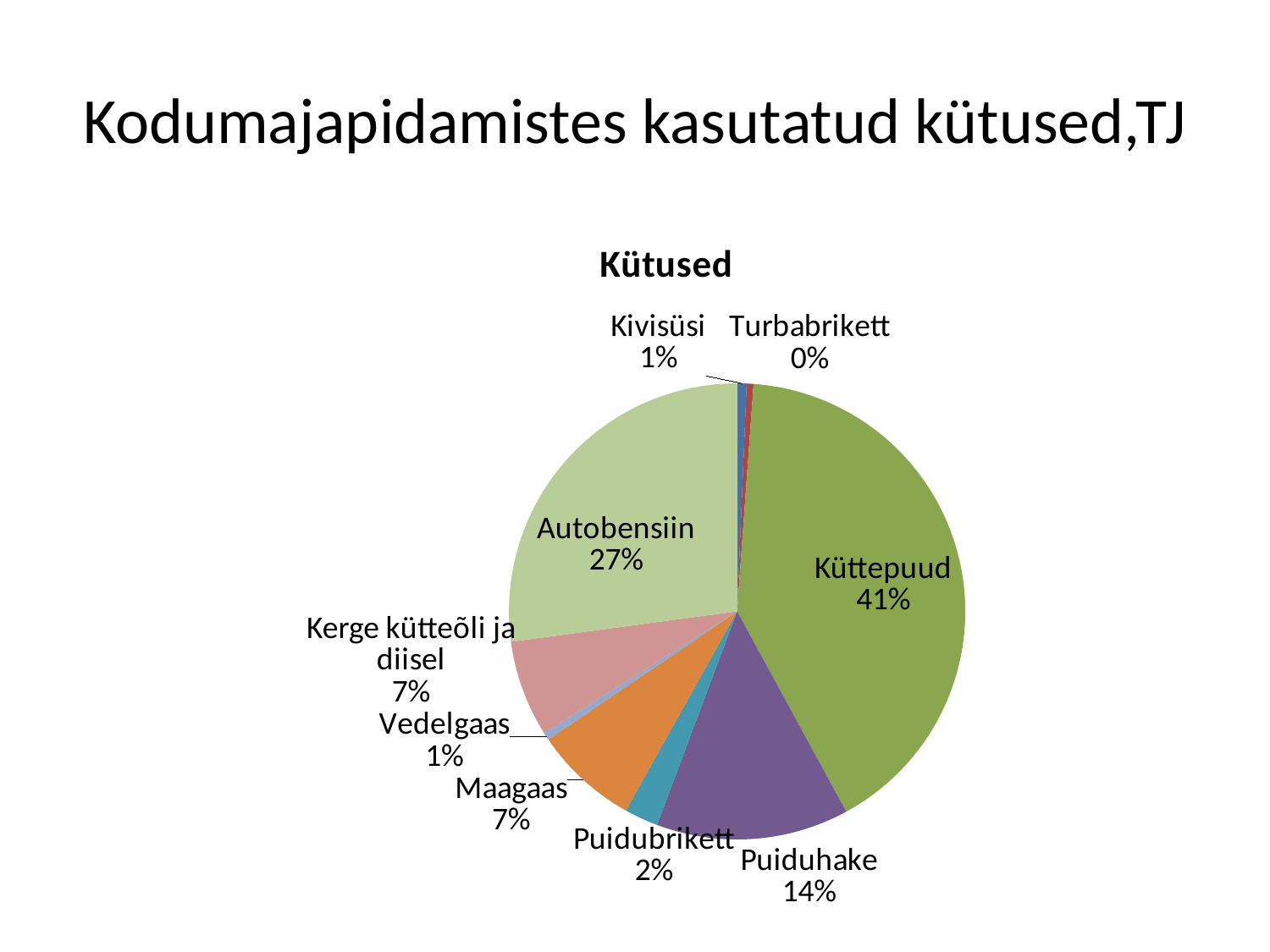
What percentage is shown for Kerge kütteõli ja diisel? 7% What kind of chart is shown on the slide? pie chart What percentage is shown for Turbabrikett? 0% What share of the pie does Puiduhake have? 14% What is the title of the chart? Kütused Which category has the largest slice of the pie? Küttepuud What percentage is shown for Puidubrikett? 2% How many categories are shown in the pie chart? 9 Which category has the smallest slice of the pie? Turbabrikett What is the difference in percentage points between Küttepuud and Autobensiin? 14 What share of the pie does Küttepuud have? 41% What share of the pie does Autobensiin have? 27%